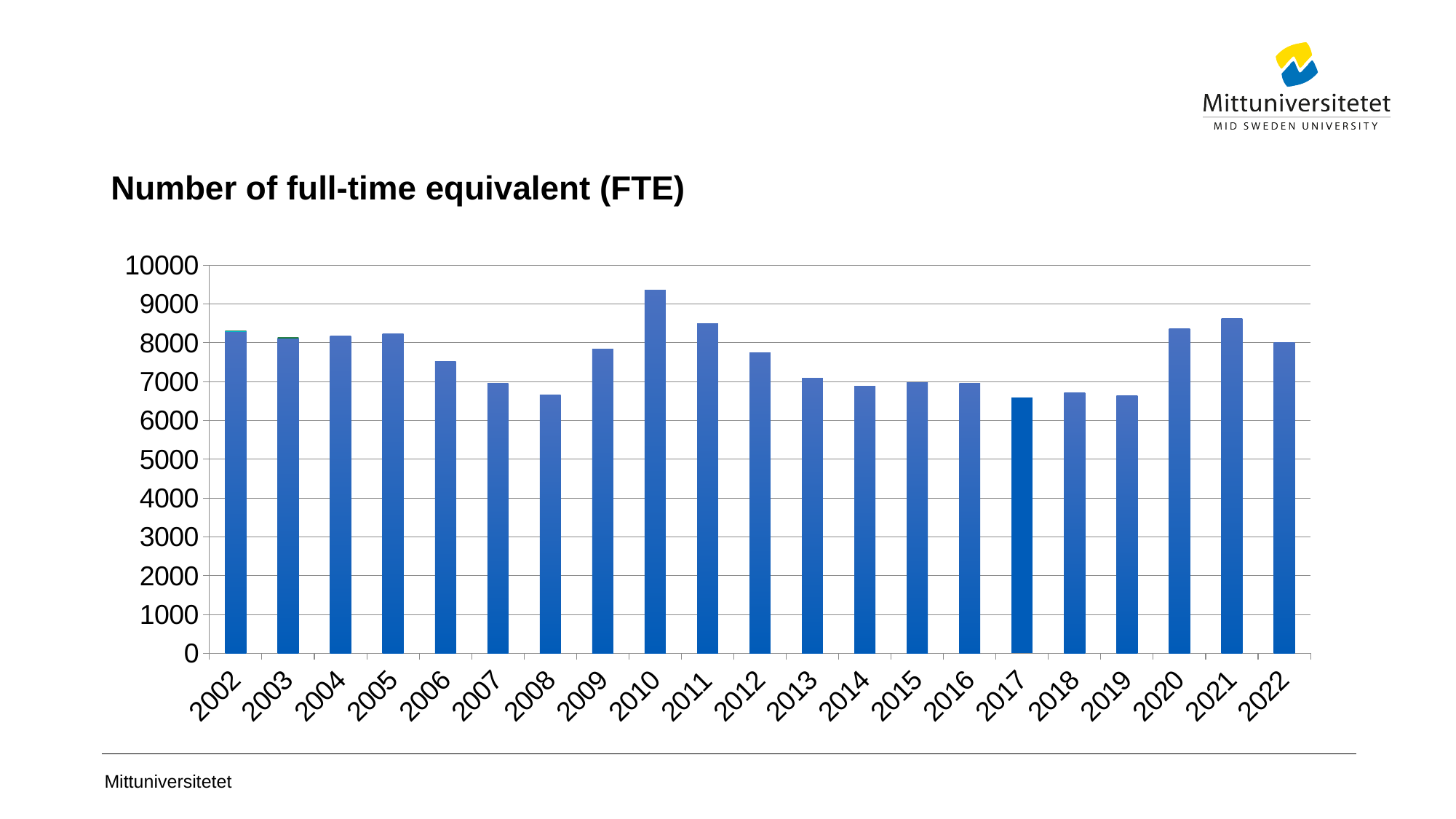
Is the value for 2021 greater or less than 8000? greater Is the value for 2012 greater or less than 8000? less Which year has the larger value, 2010 or 2011? 2010 Which year has the highest number of full-time equivalents? 2010 Is the value for 2010 greater or less than 9000? greater What is the title of the chart? Number of full-time equivalent (FTE) Which year has the larger value, 2020 or 2021? 2021 How many years are shown on the x axis of the chart? 21 Do the values rise or fall from 2010 to 2014? fall What kind of chart is shown on the slide? Bar chart